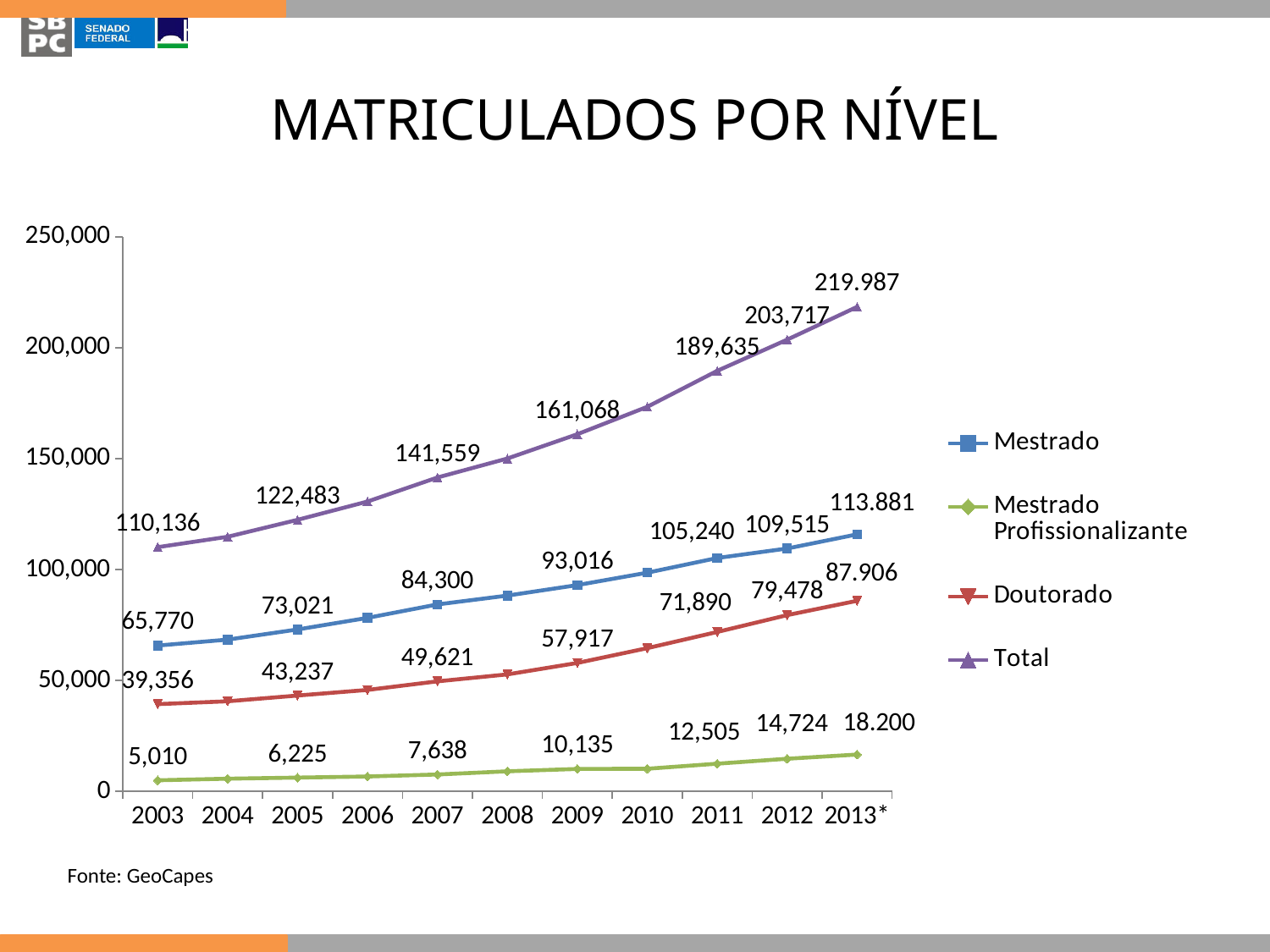
Which series has the highest value in 2013*? Total Which is larger: Doutorado in 2011 or Mestrado in 2003? Doutorado in 2011 What is the value for Doutorado in 2009? 57,917 What is the value for Mestrado in 2007? 84,300 Is the value of the Total series in 2010 greater or less than 150,000? greater What is the value for Mestrado Profissionalizante in 2013*? 18.200 What is the difference between the Mestrado values in 2012 and 2011? 4,275 Which series has the lowest value in 2003? Mestrado Profissionalizante What is the value of the Total series in 2003? 110,136 How many series does the legend list? 4 How many years are shown on the x axis? 11 What kind of chart is shown on the slide? line chart